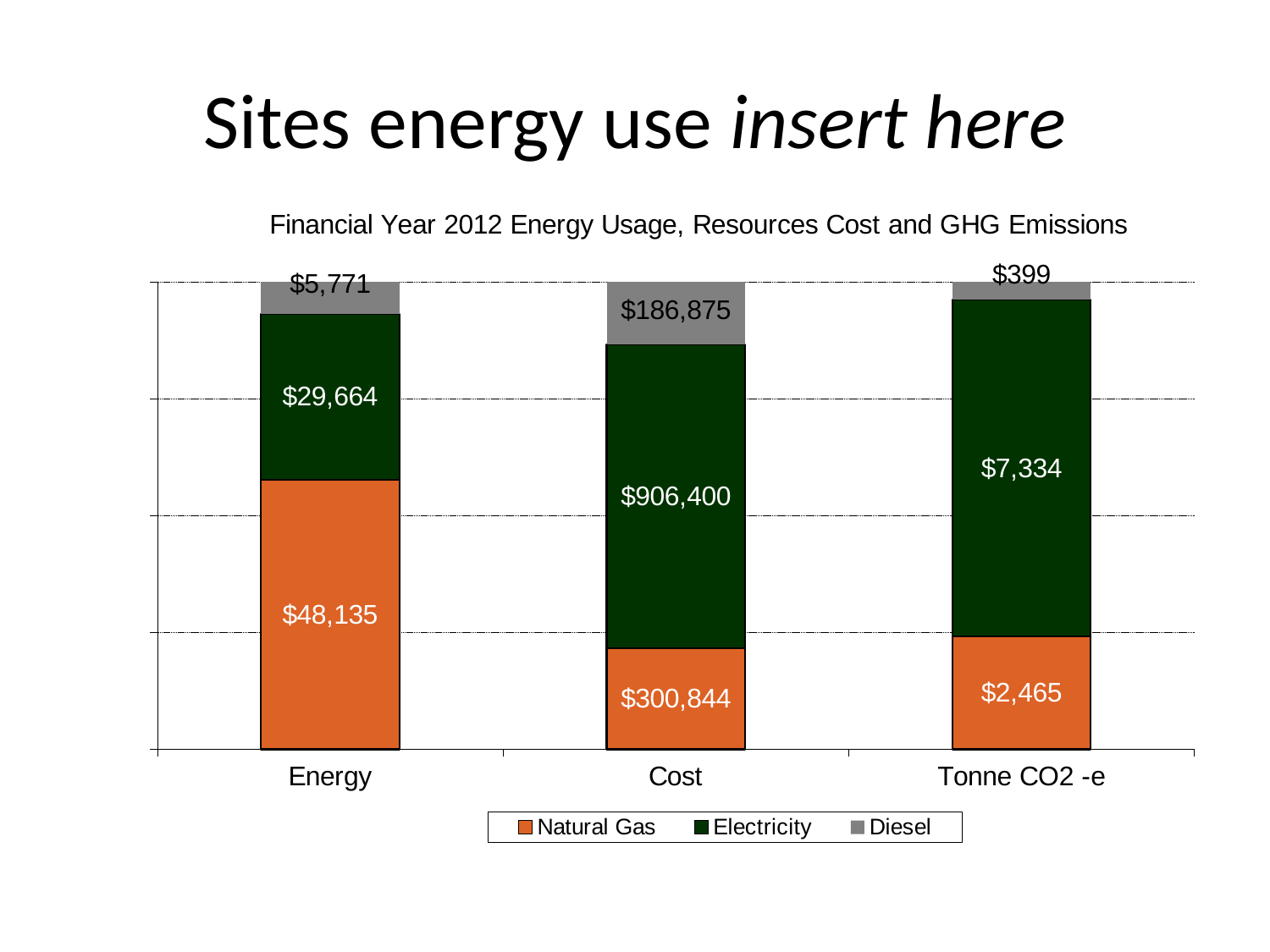
Which series has the largest segment in the Tonne CO2 -e bar? Electricity Which series has the smallest segment in the Energy bar? Diesel What is the Electricity value for the Cost bar? $906,400 What is the difference between the Electricity and Natural Gas values in the Cost bar? $605,556 What is the Diesel value for the Tonne CO2 -e bar? $399 What is the total of the three segments in the Energy bar? $83,570 What is the Natural Gas value for the Energy bar? $48,135 How many series does the legend list? 3 In the Cost bar, which is larger: the Electricity segment or the Natural Gas segment? Electricity What is the title of the chart? Financial Year 2012 Energy Usage, Resources Cost and GHG Emissions What is the Natural Gas value for the Cost bar? $300,844 What kind of chart is shown on the slide? Stacked bar chart